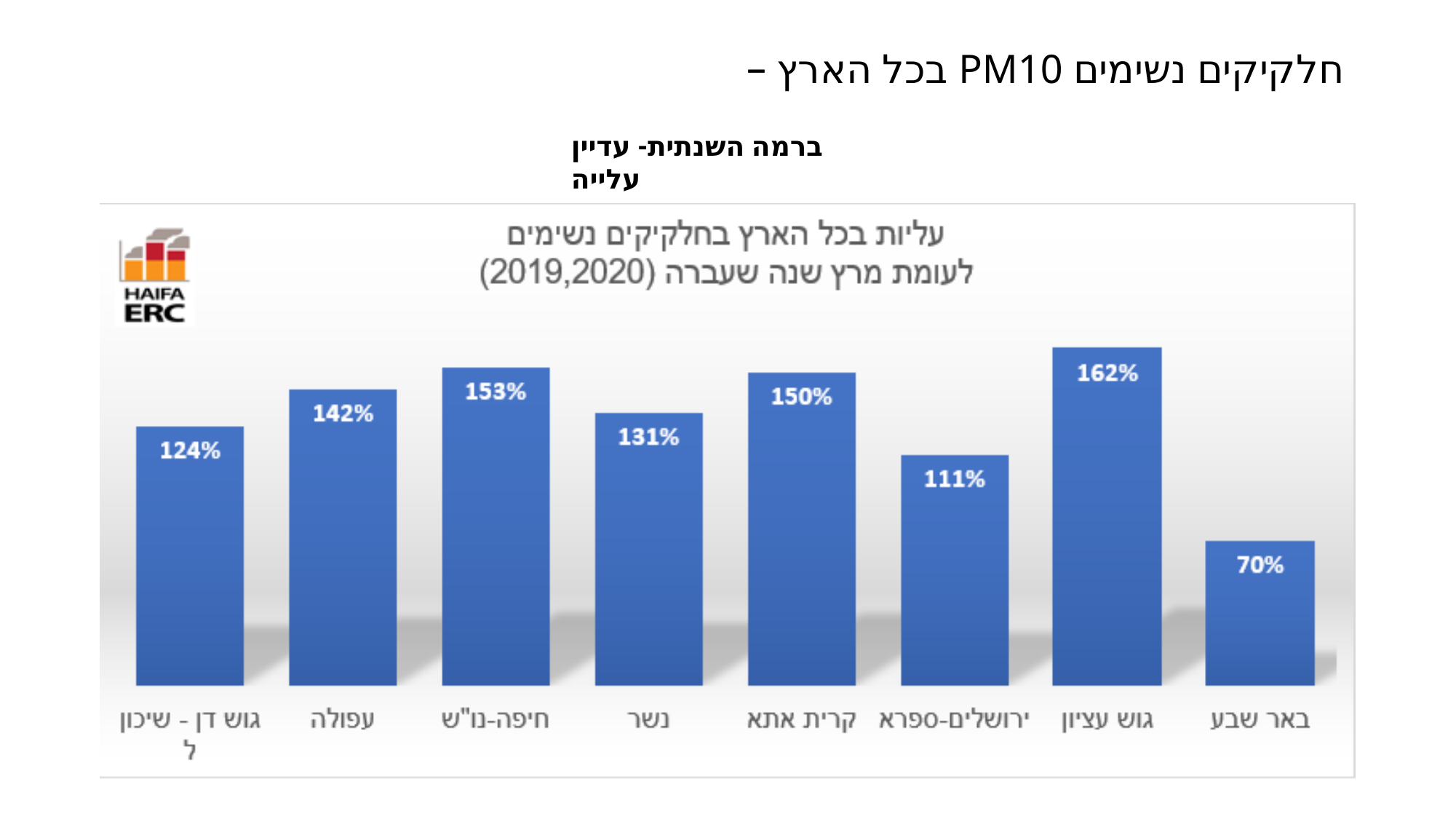
What is the value for ירושלים-ספרא? 111% What is the value for קרית אתא? 150% What is the value for עפולה? 142% Which category has the lowest value? באר שבע What is the value for באר שבע? 70% What colour are the bars in the chart? Blue How many categories are shown in the chart? 8 Which category has the highest value? גוש עציון Which is larger, the value for עפולה or the value for נשר? עפולה What is the difference between the values for גוש עציון and באר שבע? 92% What is the difference between the values for חיפה-נו"ש and נשר? 22% What kind of chart is shown on the slide? Bar chart